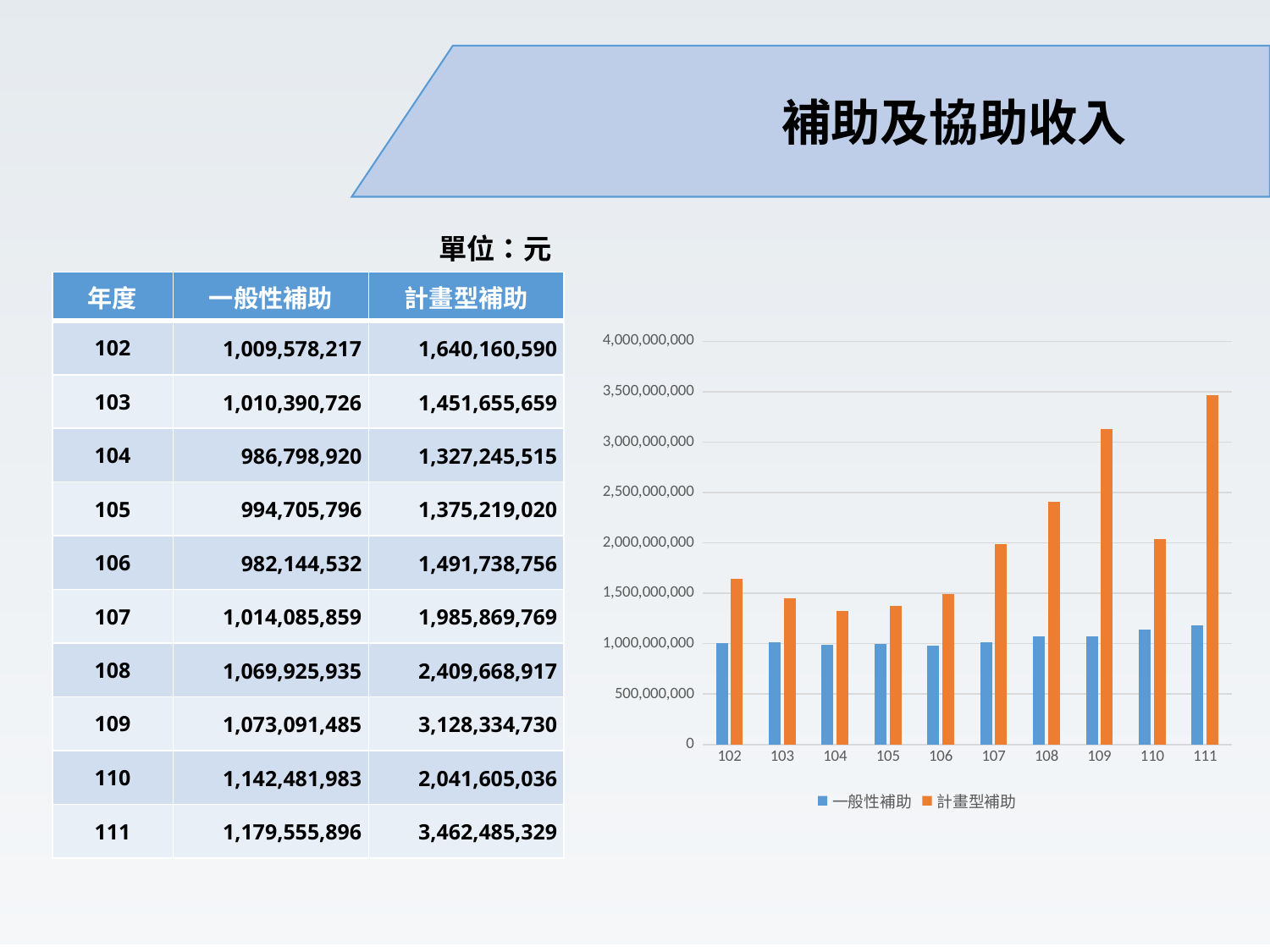
What kind of chart is shown on the slide? bar chart How many series does the chart legend list? 2 Which year has the lowest 計畫型補助 value in the chart? 104 Does the 計畫型補助 value rise or fall from year 107 to year 109? rise Is the 計畫型補助 value for year 109 greater or less than 3,000,000,000? greater How many years (categories) are plotted on the x axis of the chart? 10 According to the table, what is the 一般性補助 value for year 106? 982,144,532 Is the 計畫型補助 value for year 108 greater or less than 2,500,000,000? less Which year has the highest 計畫型補助 value in the chart? 111 In year 111, which is larger, 一般性補助 or 計畫型補助? 計畫型補助 According to the table, what is the 計畫型補助 value for year 111? 3,462,485,329 Which year has the highest 一般性補助 value? 111